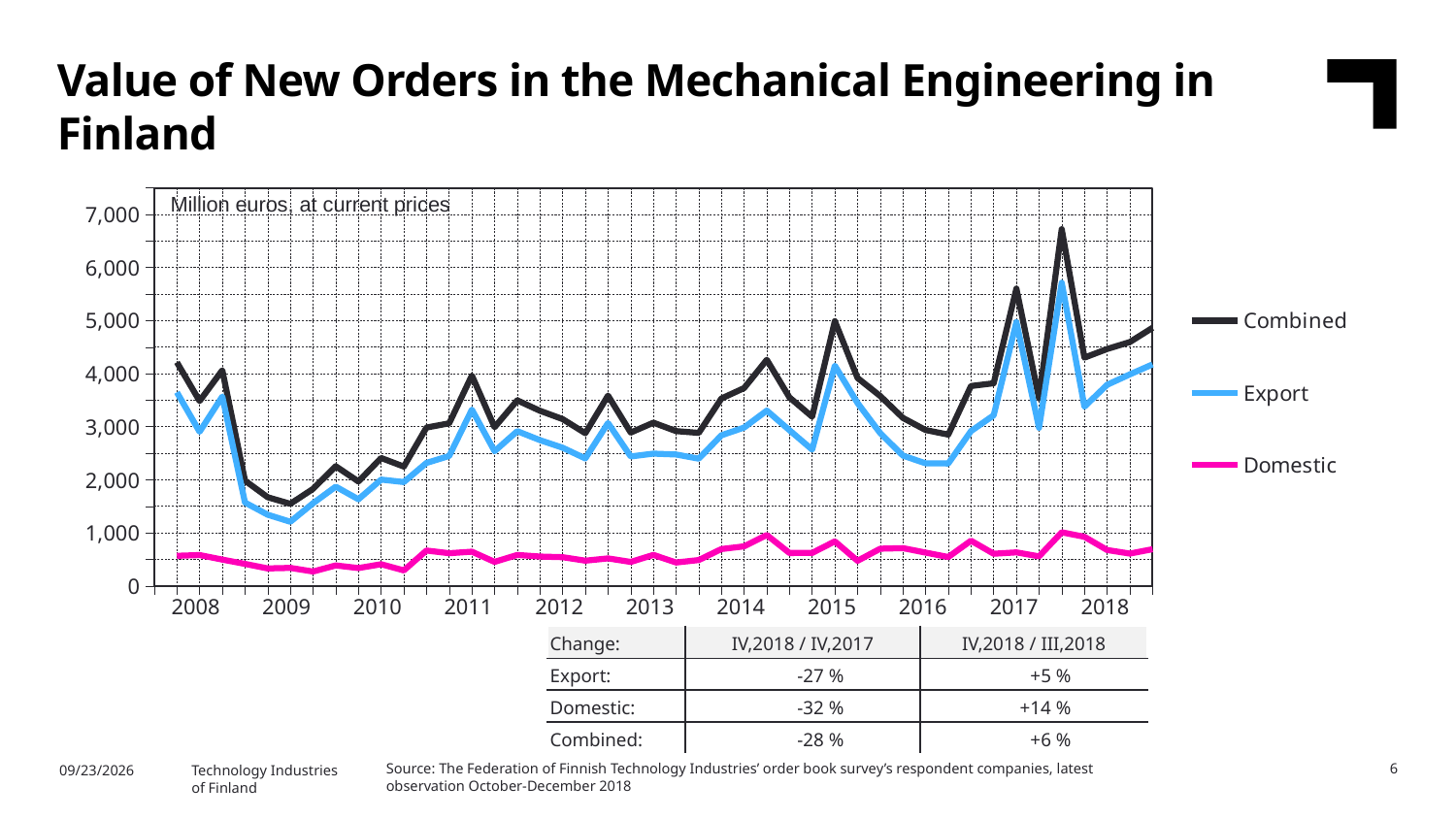
What kind of chart is shown on the slide? line chart Is the highest value reached by the Domestic series greater or less than 2,000? less How many series does the legend list? 3 How many years are labelled on the x axis? 11 Does the Combined series rise or fall from its 2009 low to 2011? rise Which series has the lowest values across the whole period? Domestic Which series has the highest values across the whole period? Combined Is the lowest Combined value in 2009 greater or less than 2,000? less Is the peak value of the Combined series in 2017 greater or less than 6,000? greater What unit label is printed inside the chart area? Million euros, at current prices What are the three series named in the legend? Combined, Export, Domestic